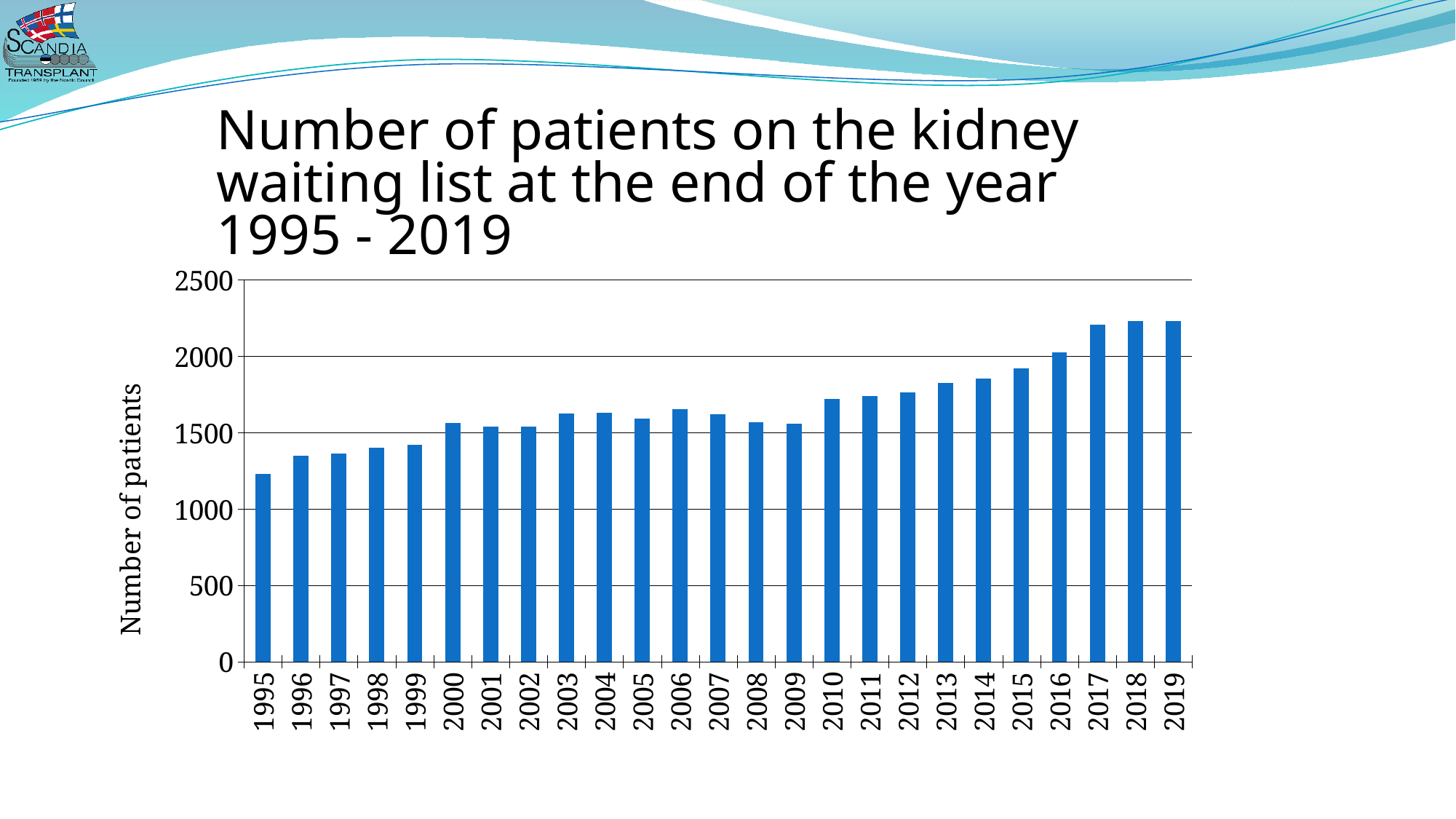
What is the label on the vertical axis? Number of patients Which is larger, the value for 1995 or the value for 2019? 2019 Is the value for 2017 greater or less than 2000? greater Is the value for 2013 greater or less than 1500? greater Which year has the lowest number of patients on the kidney waiting list? 1995 What kind of chart is shown on the slide? bar chart Is the value for 1998 greater or less than 1500? less Which is larger, the value for 2015 or the value for 2010? 2015 Overall, do the values rise or fall from 1995 to 2019? rise How many years are plotted on the x axis? 25